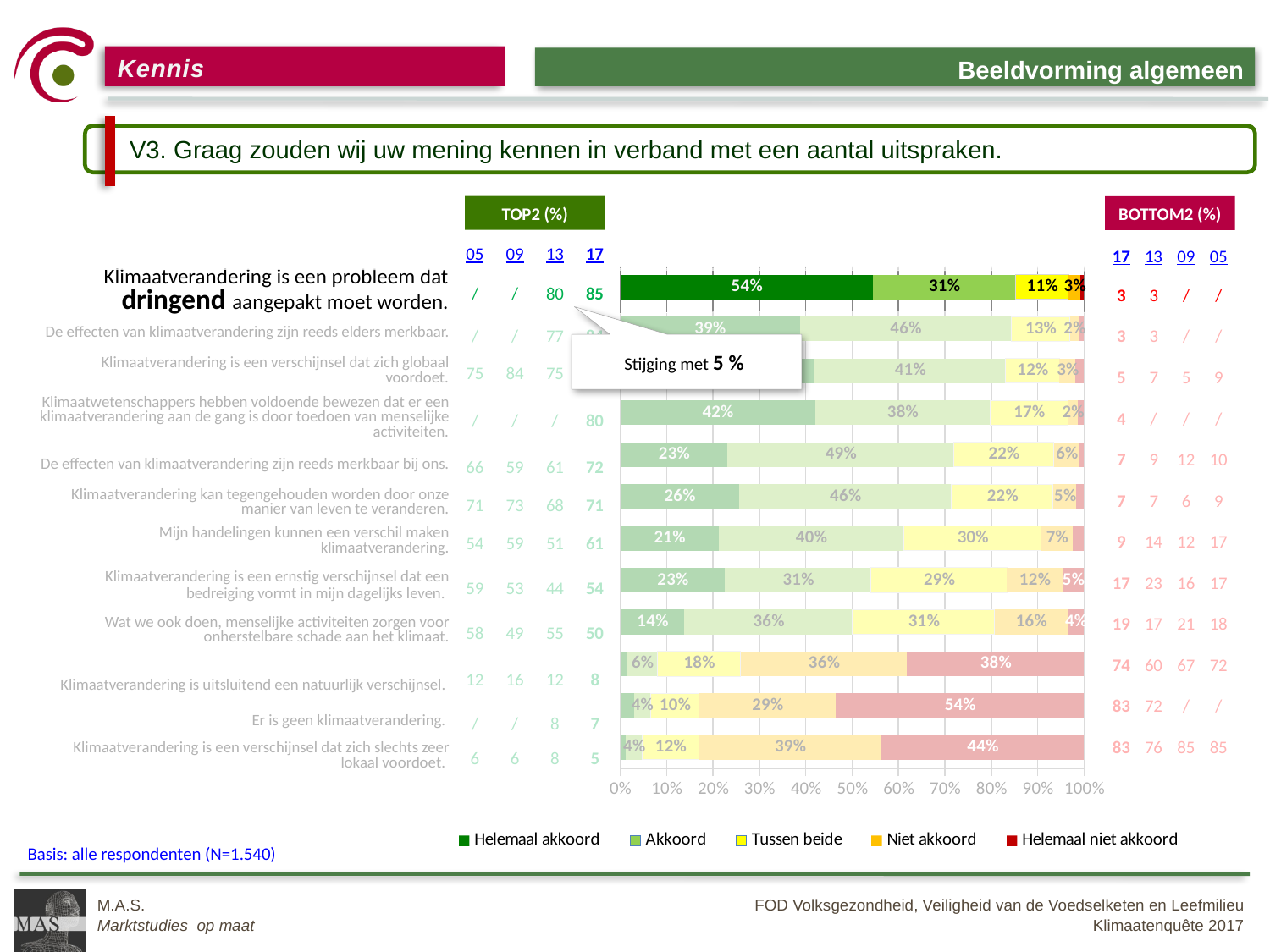
What type of chart is shown on the slide? Stacked bar chart What is the difference between the 'Helemaal akkoord' and 'Akkoord' percentages for the statement 'Klimaatverandering is een probleem dat dringend aangepakt moet worden'? 23 percentage points What is the 'Tussen beide' share for the statement 'Klimaatverandering is een probleem dat dringend aangepakt moet worden'? 11% How many answer categories does the legend list? 5 What does the callout box on the chart say? Stijging met 5 % What percentage of respondents answered 'Helemaal akkoord' to the statement 'Klimaatverandering is een probleem dat dringend aangepakt moet worden'? 54% Which statement has the highest 'Helemaal akkoord' percentage? Klimaatverandering is een probleem dat dringend aangepakt moet worden What is the 'Helemaal niet akkoord' share for the statement 'Er is geen klimaatverandering'? 54% How many statements are plotted in the chart? 12 What is the TOP2 (%) value for 2017 for the statement 'Klimaatverandering is een probleem dat dringend aangepakt moet worden'? 85 For the statement 'Klimaatverandering is uitsluitend een natuurlijk verschijnsel', which is larger: the 'Tussen beide' share or the 'Helemaal niet akkoord' share? Helemaal niet akkoord What percentage answered 'Akkoord' to the statement 'Klimaatverandering is een probleem dat dringend aangepakt moet worden'? 31%